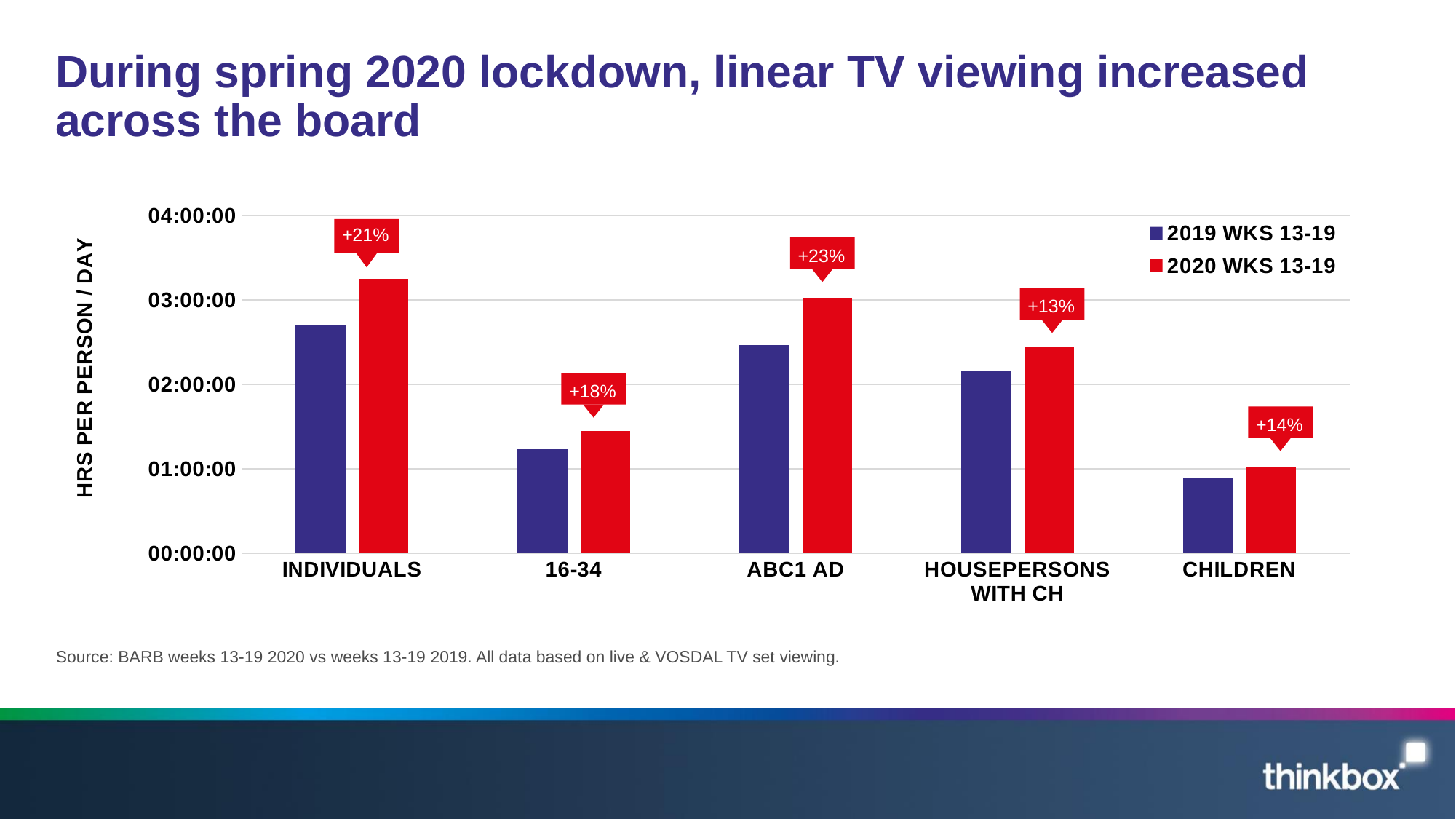
What percentage increase is labelled for INDIVIDUALS? +21% Is the 2020 WKS 13-19 value for INDIVIDUALS greater or less than 03:00:00? greater Which category has the smallest labelled percentage increase? HOUSEPERSONS WITH CH Which colour represents the 2020 WKS 13-19 series? red Which category has the largest labelled percentage increase? ABC1 AD How many audience categories are shown on the x axis? 5 What kind of chart is shown on the slide? bar chart What percentage increase is labelled for HOUSEPERSONS WITH CH? +13% How many series does the legend list? 2 What percentage increase is labelled for ABC1 AD? +23% Is the 2019 WKS 13-19 value for CHILDREN greater or less than 01:00:00? less Which category has the lowest viewing in both years? CHILDREN